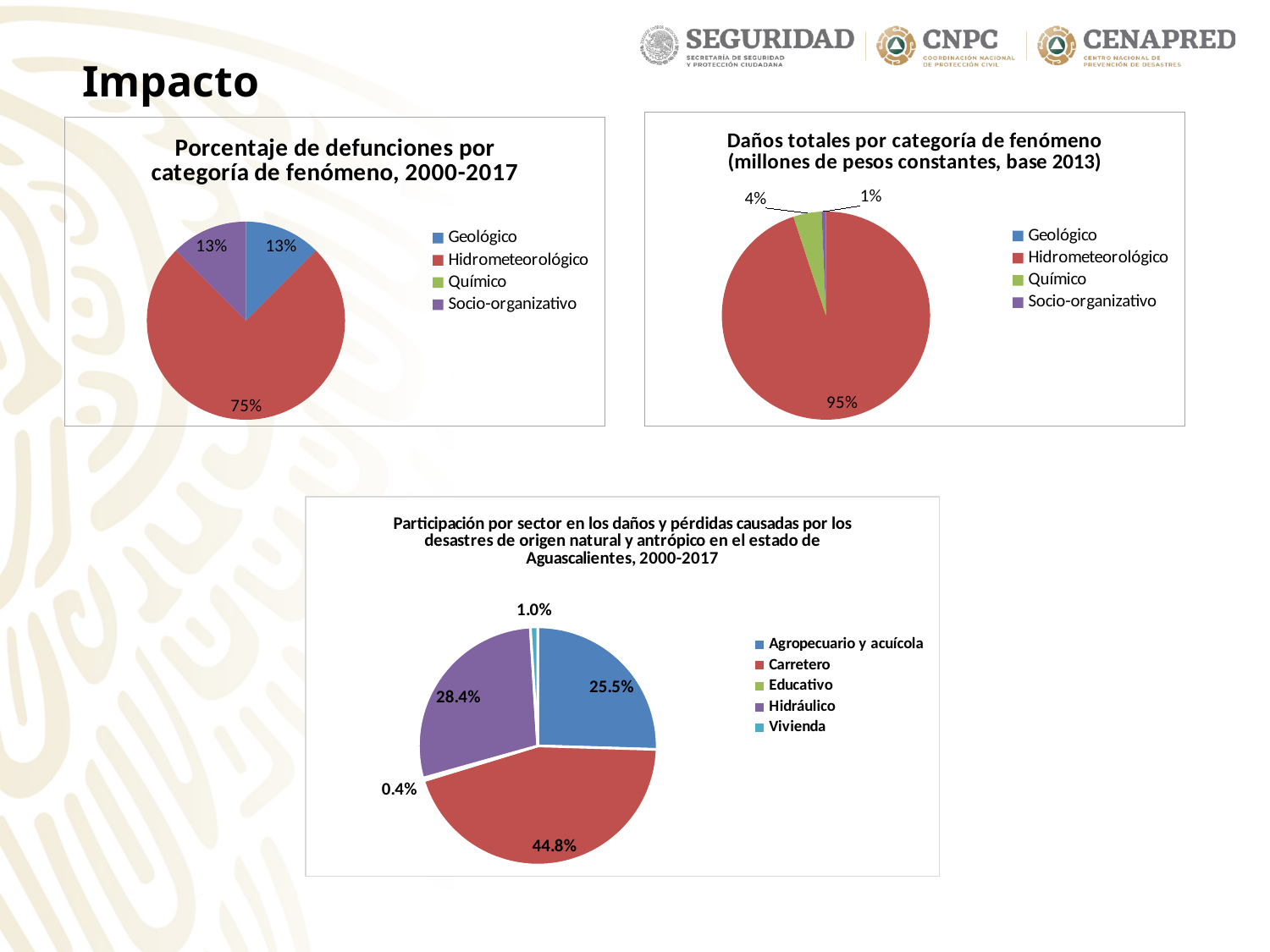
In the bottom chart about Aguascalientes, which is larger: Agropecuario y acuícola or Hidráulico? Hidráulico In the bottom chart about Aguascalientes, what share is shown for Hidráulico? 28.4% In the bottom chart about Aguascalientes, which sector has the smallest slice? Educativo In the chart titled "Daños totales por categoría de fenómeno (millones de pesos constantes, base 2013)", what is the difference between the Hidrometeorológico and Químico percentages? 91% In the bottom chart about Aguascalientes, what share is shown for Carretero? 44.8% In the chart titled "Porcentaje de defunciones por categoría de fenómeno, 2000-2017", what percentage is shown for Hidrometeorológico? 75% In the chart titled "Daños totales por categoría de fenómeno (millones de pesos constantes, base 2013)", what percentage is shown for Químico? 4% What kind of chart is the one titled "Daños totales por categoría de fenómeno (millones de pesos constantes, base 2013)"? Pie chart In the chart titled "Porcentaje de defunciones por categoría de fenómeno, 2000-2017", what percentage is shown for Geológico? 13% In the chart titled "Porcentaje de defunciones por categoría de fenómeno, 2000-2017", which category has the largest slice? Hidrometeorológico How many entries does the legend list in the chart titled "Porcentaje de defunciones por categoría de fenómeno, 2000-2017"? 4 In the chart titled "Daños totales por categoría de fenómeno (millones de pesos constantes, base 2013)", what percentage is shown for Hidrometeorológico? 95%